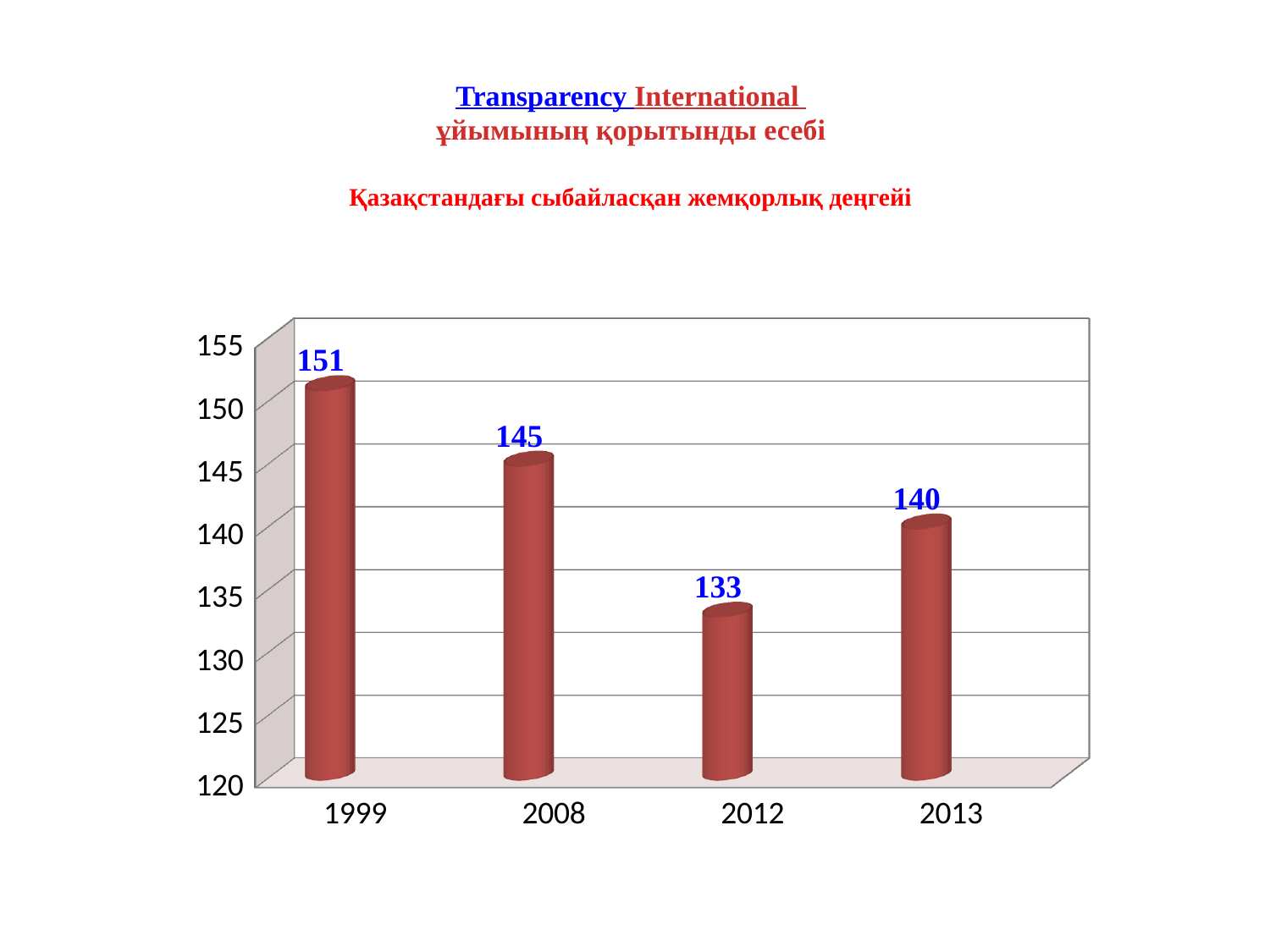
What is the difference between the values for 1999 and 2012? 18 What is the value for 2013? 140 What kind of chart is shown on the slide? bar chart Which year has the highest value? 1999 What is the value for 2012? 133 How many years are shown on the x axis? 4 Do the values rise or fall from 1999 to 2012? fall What is the value for 1999? 151 What is the value for 2008? 145 What is the difference between the values for 2013 and 2008? 5 Which is larger, the value for 2008 or the value for 2013? 2008 Which year has the lowest value? 2012